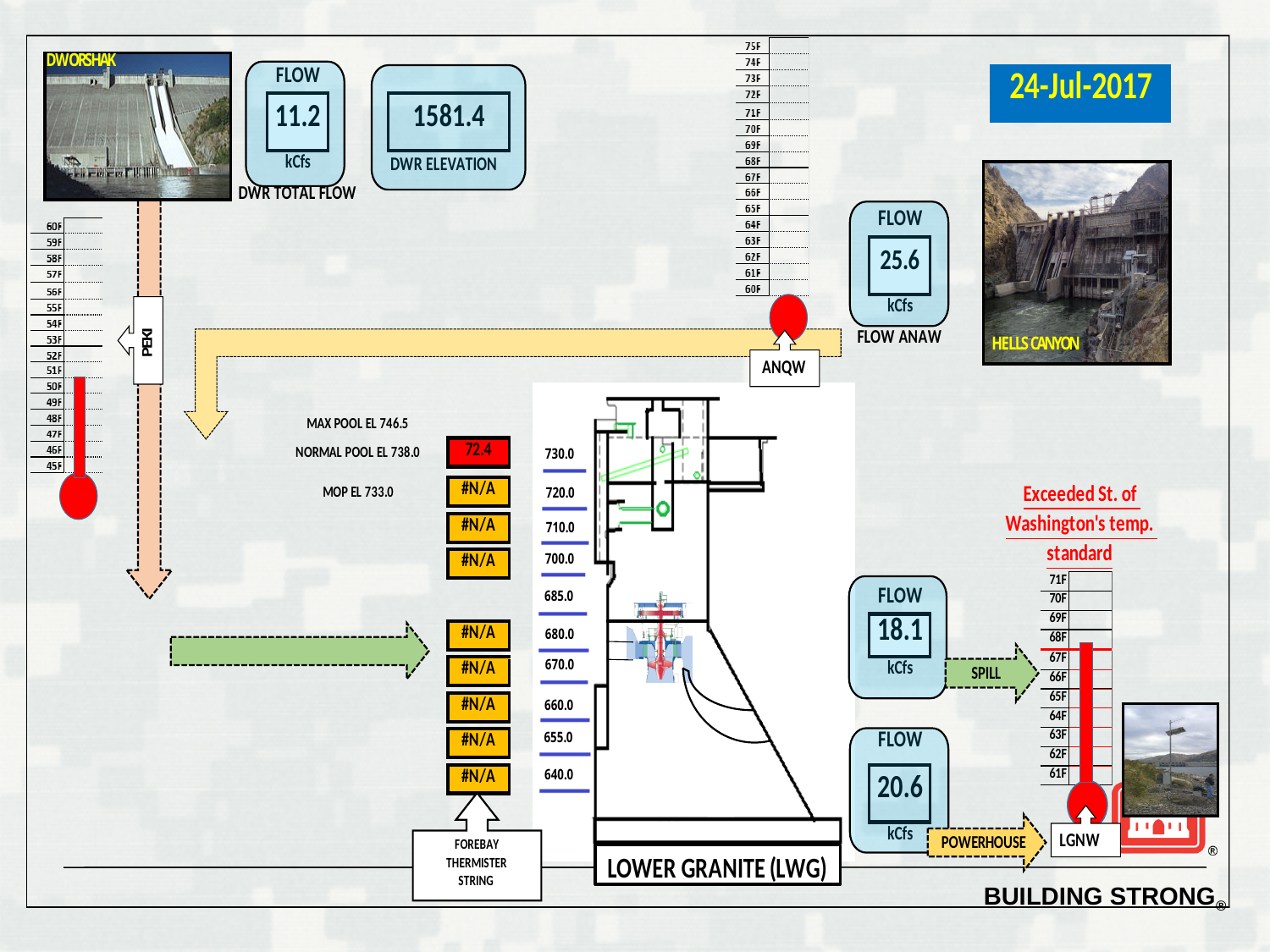
What is the FLOW ANAW value shown? 25.6 kCfs What date is shown on the slide? 24-Jul-2017 Which is larger at Lower Granite, the spill flow or the powerhouse flow? Powerhouse flow What is the spill flow value shown for Lower Granite? 18.1 kCfs What is the difference between the powerhouse flow (20.6) and the spill flow (18.1) at Lower Granite? 2.5 kCfs What is the DWR total flow value shown for Dworshak? 11.2 kCfs What is the powerhouse flow value shown for Lower Granite? 20.6 kCfs On the LGNW thermometer, is the temperature reading greater or less than 65F? greater What is the topmost reading shown in the forebay thermistor string? 72.4 What DWR elevation is shown on the slide? 1581.4 How many forebay thermistor string boxes show #N/A? 8 Of the four flow values shown on the slide, which is the highest? FLOW ANAW (25.6 kCfs)